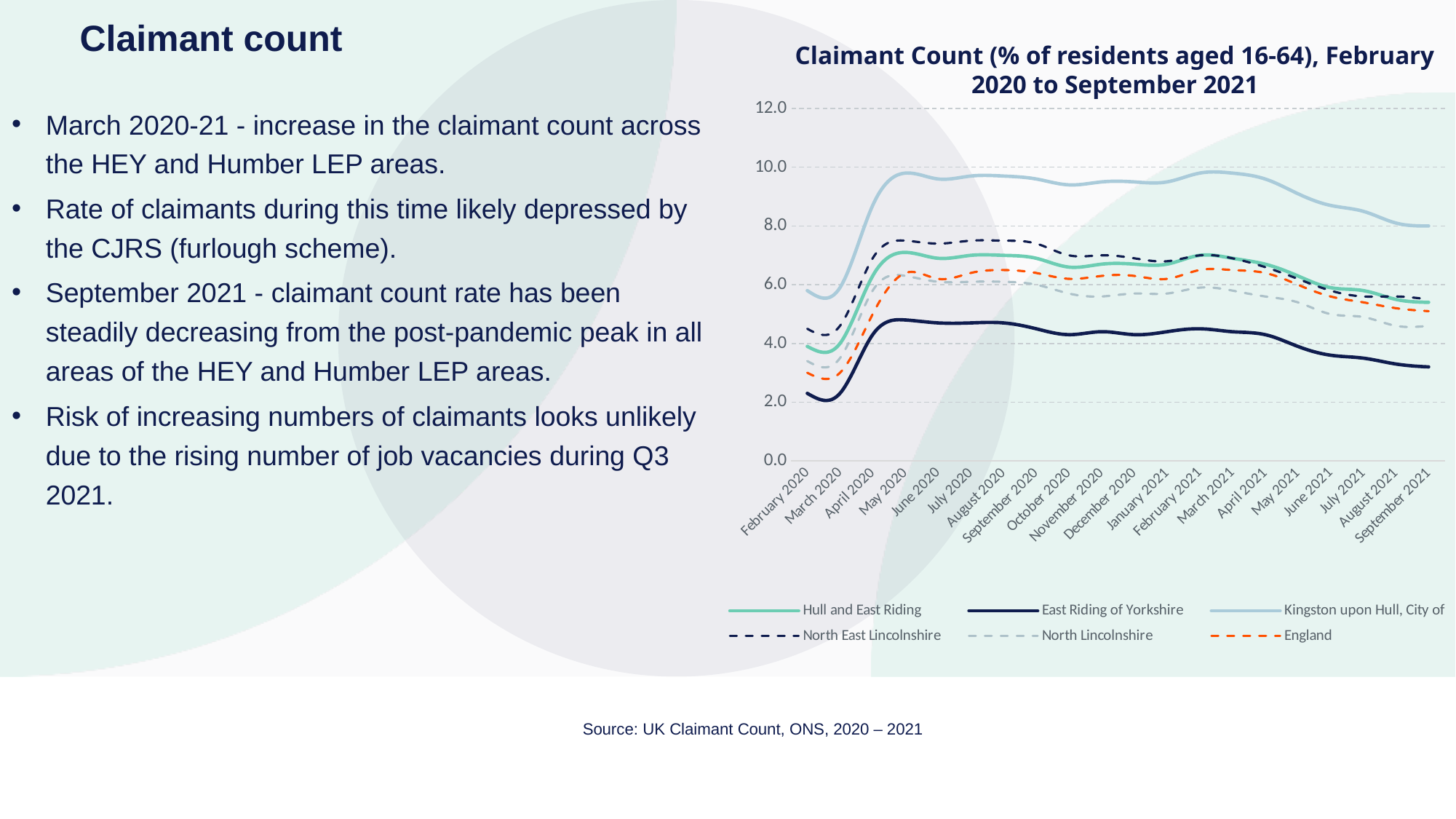
Is the value for Hull and East Riding in May 2020 greater or less than 6.0? greater What is the title of the chart? Claimant Count (% of residents aged 16-64), February 2020 to September 2021 Is the value for Kingston upon Hull, City of in May 2020 greater or less than 8.0? greater What kind of chart is shown on the slide? Line chart Which area has the lowest claimant count in May 2020? East Riding of Yorkshire Which is larger in September 2021, the value for Kingston upon Hull, City of or the value for East Riding of Yorkshire? Kingston upon Hull, City of Does the value for Kingston upon Hull, City of rise or fall between February 2020 and May 2020? Rise Which area has the highest claimant count in May 2020? Kingston upon Hull, City of How many months are shown along the x axis? 20 How many series does the legend list? 6 Does the value for East Riding of Yorkshire rise or fall between March 2021 and September 2021? Fall Is the value for East Riding of Yorkshire in February 2020 greater or less than 4.0? less